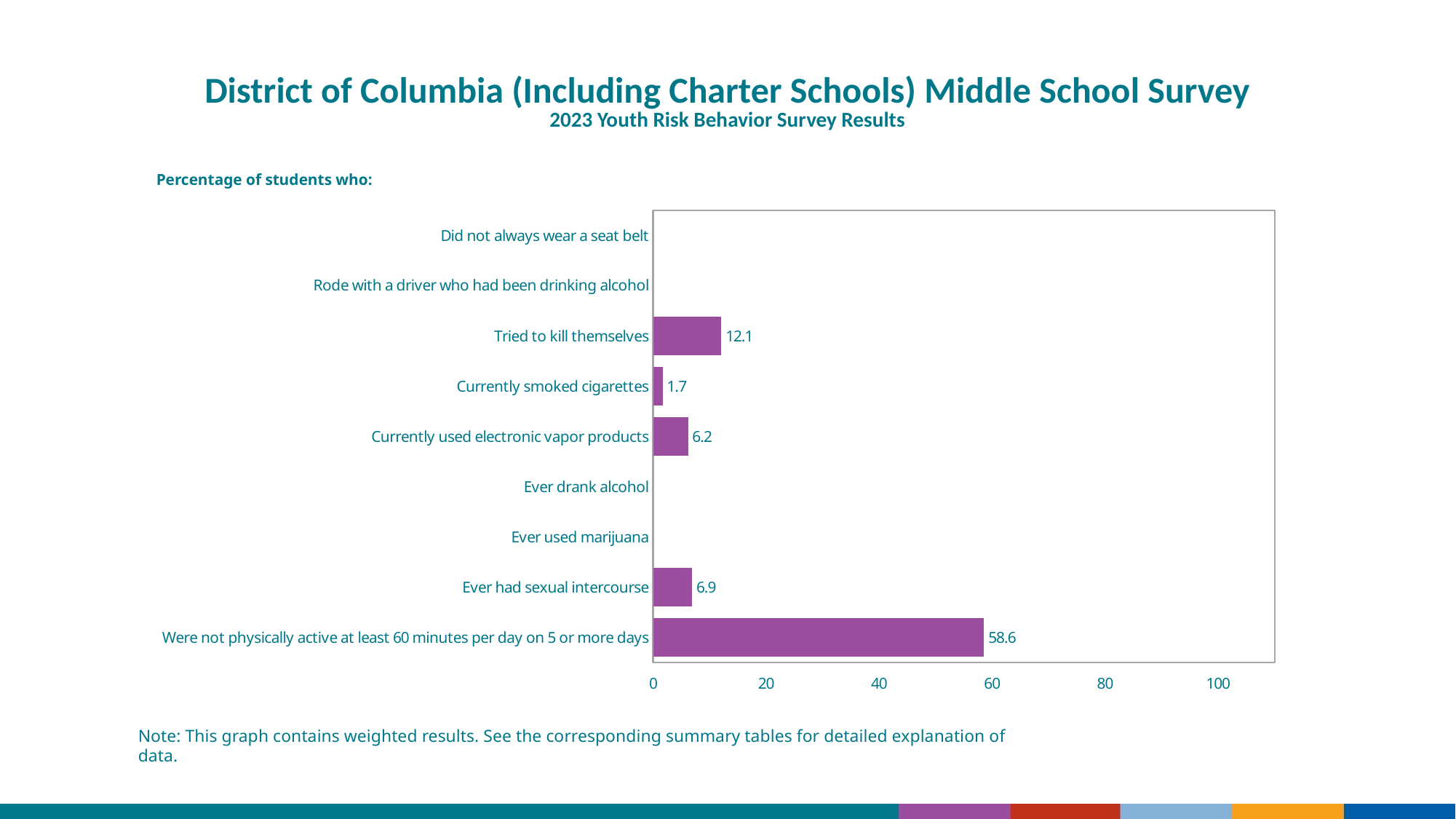
How many categories are listed on the y axis of the chart? 9 What is the difference between the value for 'Tried to kill themselves' and the value for 'Currently smoked cigarettes'? 10.4 Which category has the highest value on the chart? Were not physically active at least 60 minutes per day on 5 or more days Is the value for 'Were not physically active at least 60 minutes per day on 5 or more days' greater or less than 40? greater Which is larger: the value for 'Ever had sexual intercourse' or the value for 'Currently used electronic vapor products'? Ever had sexual intercourse What percentage of students were not physically active at least 60 minutes per day on 5 or more days? 58.6 What percentage of students currently smoked cigarettes? 1.7 What kind of chart is shown on the slide? bar chart What percentage of students currently used electronic vapor products? 6.2 What is the subtitle shown under the main title of the slide? 2023 Youth Risk Behavior Survey Results What percentage of students tried to kill themselves? 12.1 Among the categories with a bar shown, which has the lowest value? Currently smoked cigarettes